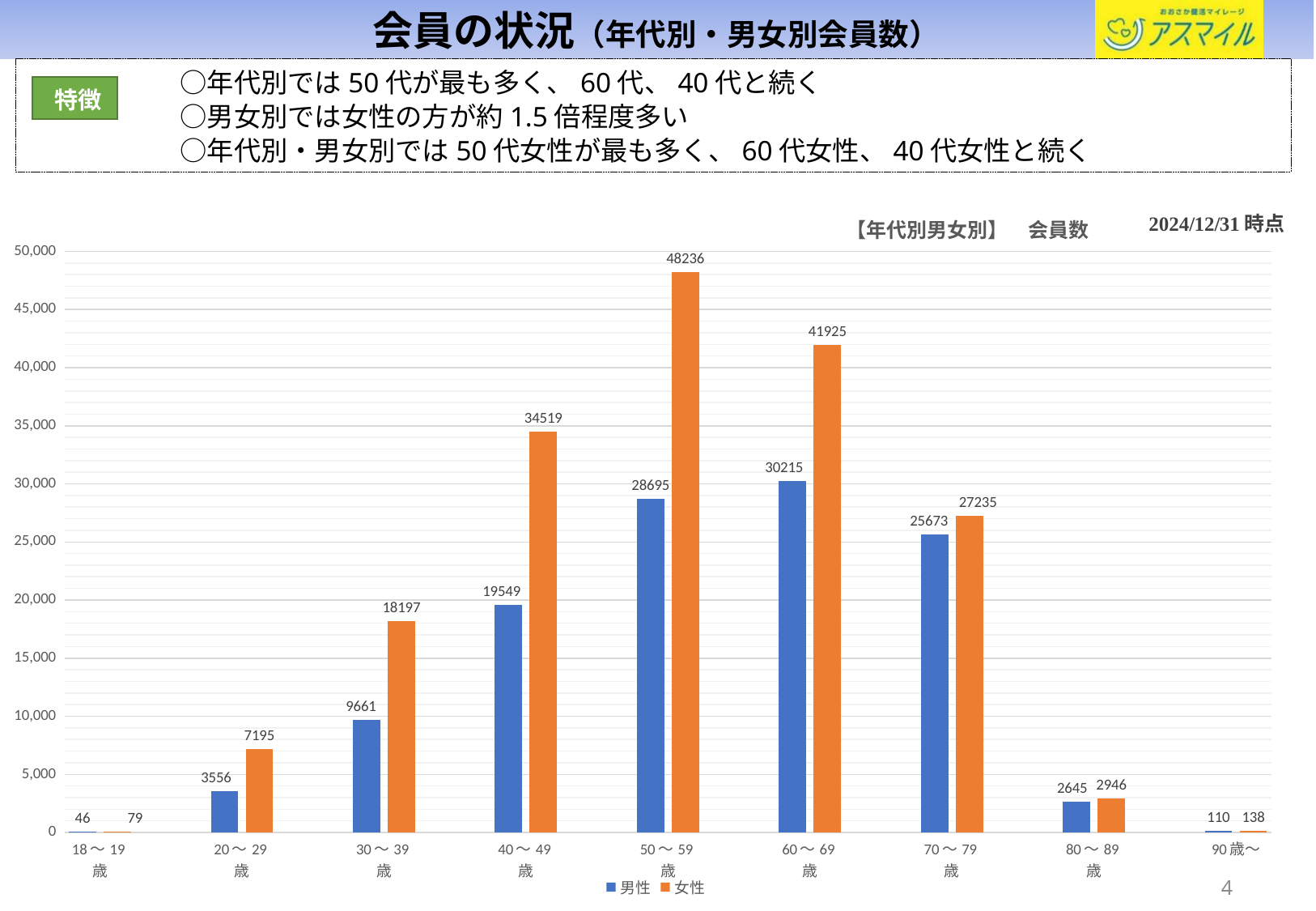
What are the two entries in the chart legend? 男性, 女性 What is the value for 男性 in the 60～69歳 age group? 30215 In the 50～59歳 age group, how much larger is the 女性 value than the 男性 value? 19541 What is the value for 女性 in the 80～89歳 age group? 2946 How many series does the legend list? 2 What kind of chart is shown on the slide? bar chart What is the difference between the 男性 values for 60～69歳 and 50～59歳? 1520 What is the value for 女性 in the 50～59歳 age group? 48236 Which age group has the highest value for 男性? 60～69歳 How many age groups are shown on the x axis? 9 Which age group has the lowest value for 女性? 18～19歳 In the 70～79歳 age group, which is larger, 男性 or 女性? 女性